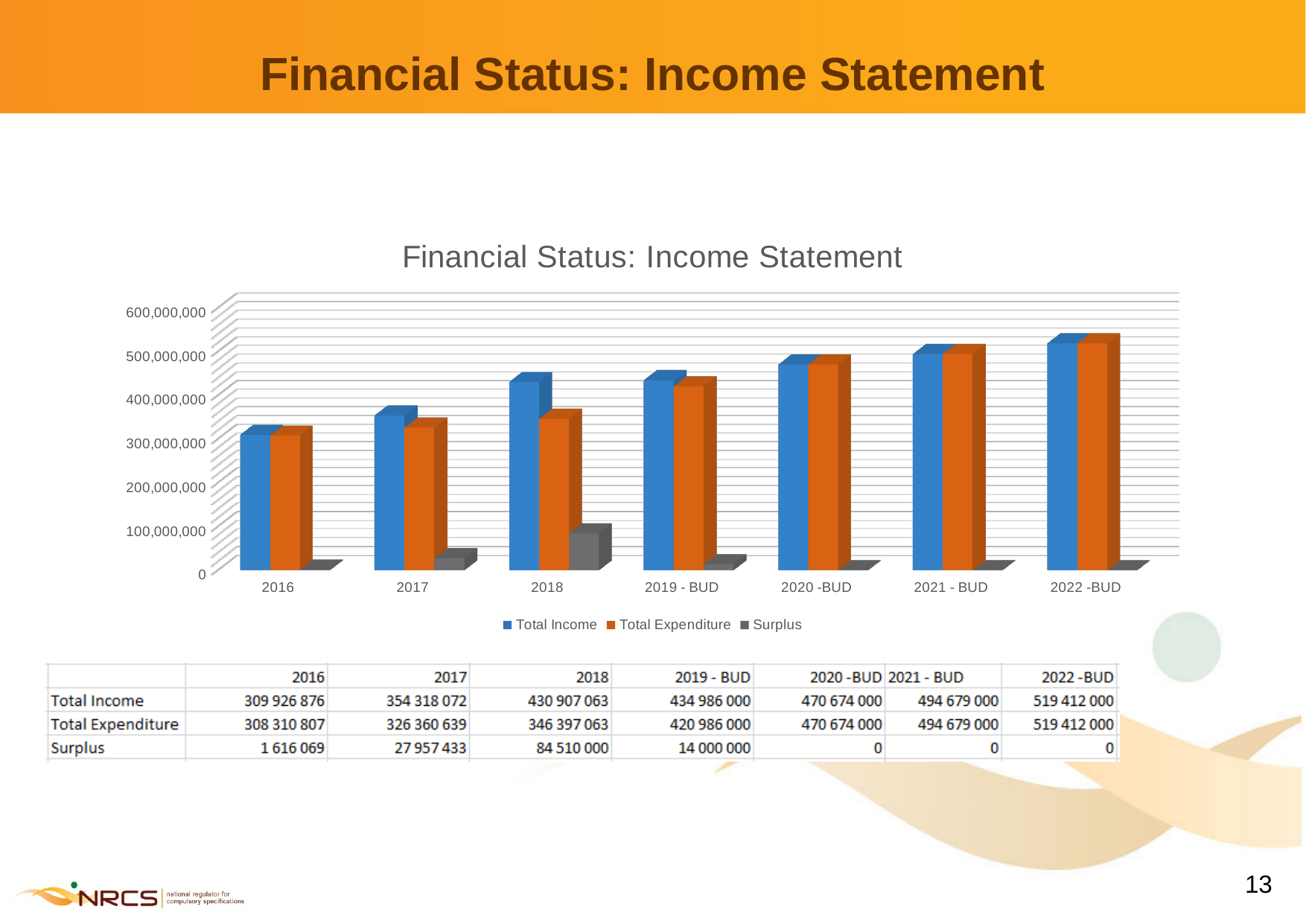
What is the Total Income value for 2018? 430 907 063 In which year is Total Income lowest? 2016 What is the difference between Total Income and Total Expenditure for 2019 - BUD? 14 000 000 Does Total Income rise or fall from 2016 to 2022 -BUD? Rise What is the Surplus value for 2017? 27 957 433 How many year categories are shown along the x axis of the chart? 7 How many series does the chart's legend list? 3 What kind of chart is shown on the slide? Bar chart Which is larger, Total Expenditure in 2017 or Total Expenditure in 2018? 2018 In which year is the Surplus highest? 2018 Is the Total Income value for 2022 -BUD greater or less than 500,000,000? greater What is the Total Expenditure value for 2019 - BUD? 420 986 000